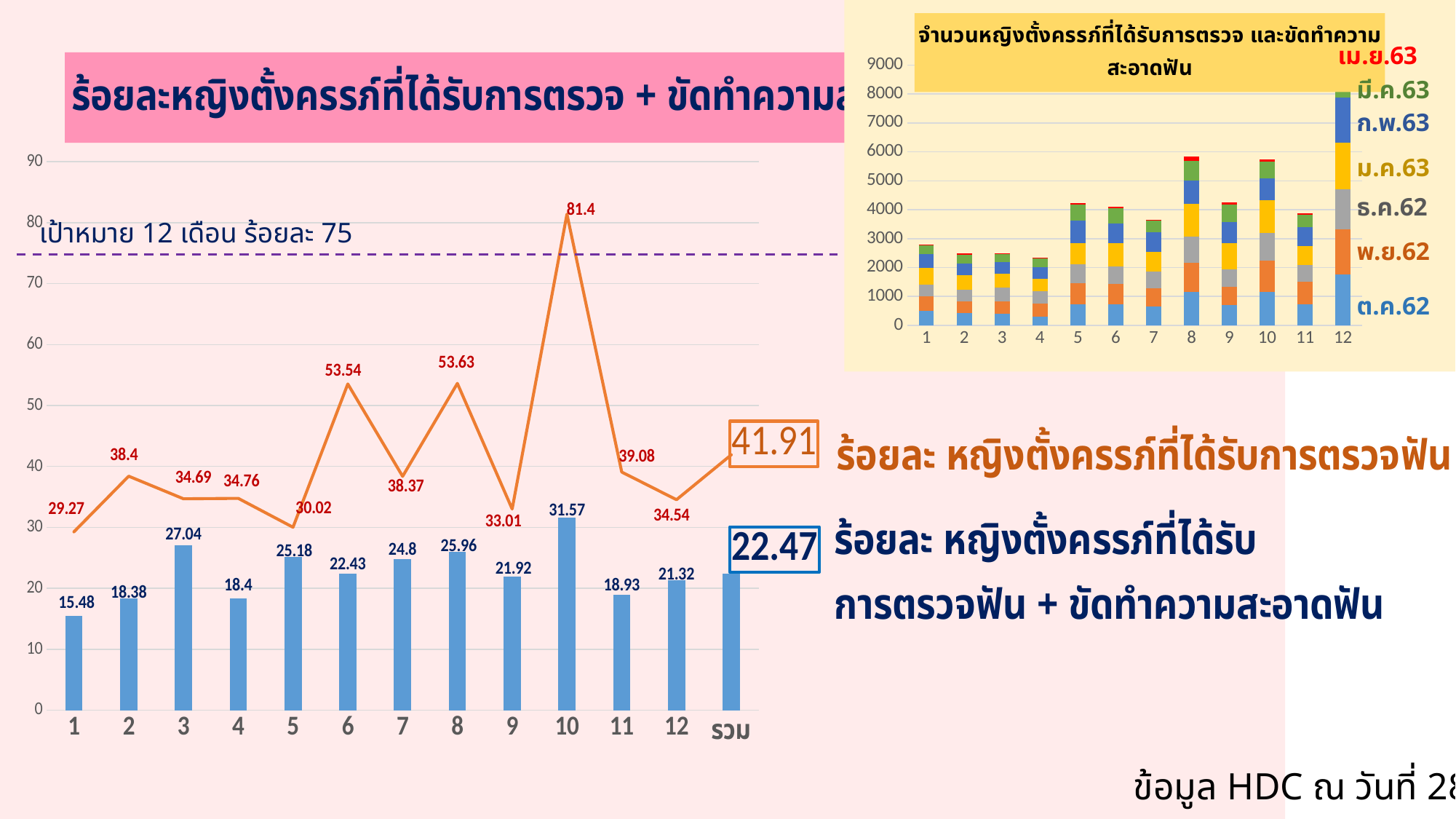
In the large chart on the left, what is the value of the blue bar for category 3? 27.04 In the large chart on the left, what is the difference between the orange line values for category 10 and category 9? 48.39 In the large chart on the left, what target percentage does the dashed line represent? 75 In the large chart on the left, what is the value of the blue bar for the รวม category? 22.47 In the large chart on the left, which category has the lowest blue bar? 1 In the large chart on the left, which is larger: the blue bar for category 5 or the blue bar for category 7? category 5 In the stacked bar chart on the top right, which category has the tallest stacked bar? 12 In the large chart on the left, what is the value of the orange line for category 10? 81.4 In the stacked bar chart on the top right, is the total for category 12 greater or less than 7000? greater In the large chart on the left, what is the value of the orange line for the รวม category? 41.91 In the large chart on the left, which category has the highest value on the orange line? 10 In the stacked bar chart on the top right, how many series does the legend list? 7